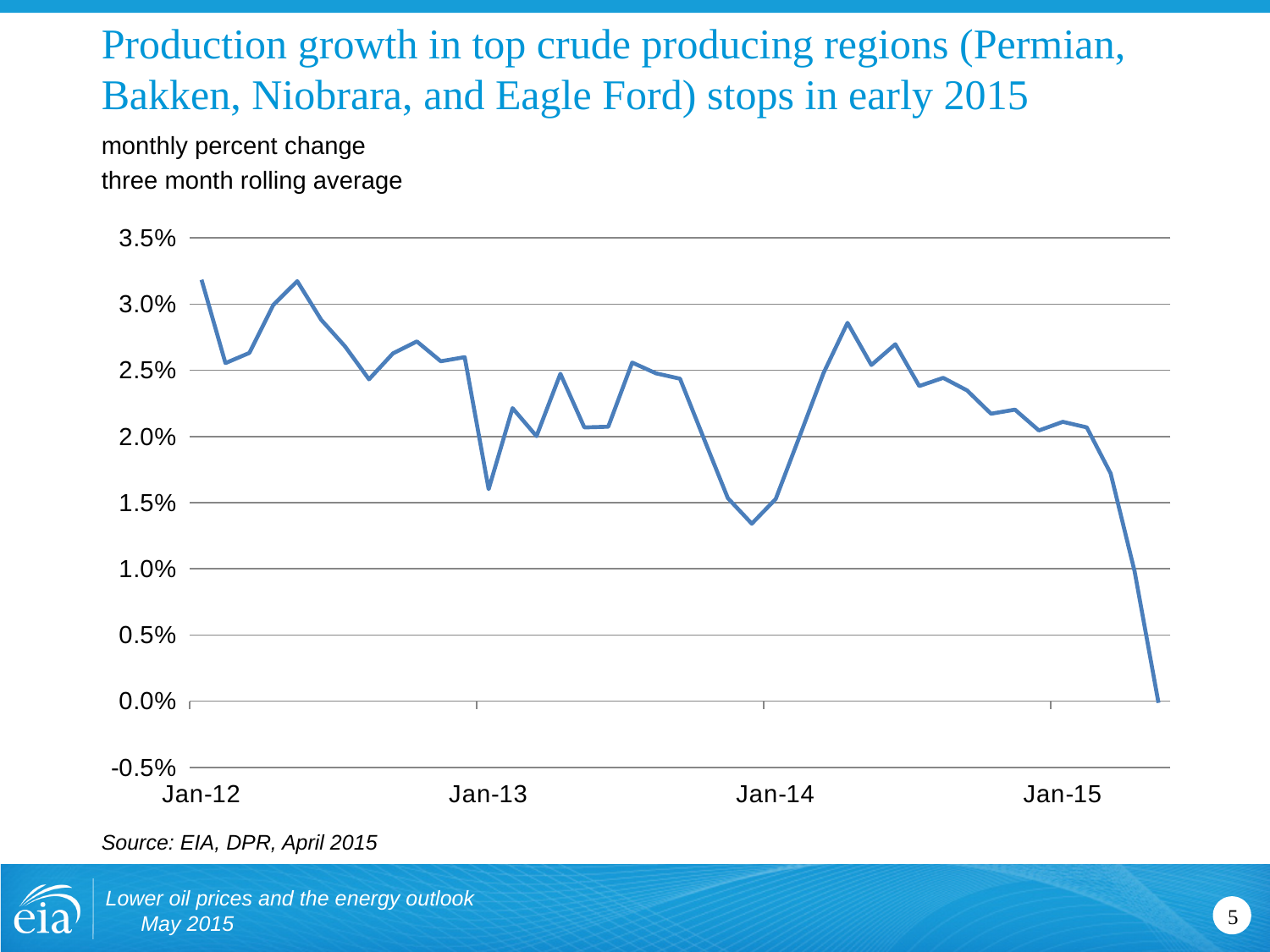
Is the final value of the line greater or less than 0.5%? less Is the value at Jan-13 greater or less than 2.0%? less How many year labels are shown on the x axis? 4 What unit does the chart's subtitle say the values are in? monthly percent change, three month rolling average Does the line overall rise or fall from Jan-12 to the end of the series? fall Is the value at Jan-12 greater or less than 3.0%? greater What kind of chart is shown on the slide? line chart Is the lowest point of the line at the start or at the end of the series? end Which is larger, the value at Jan-12 or the value at Jan-15? Jan-12